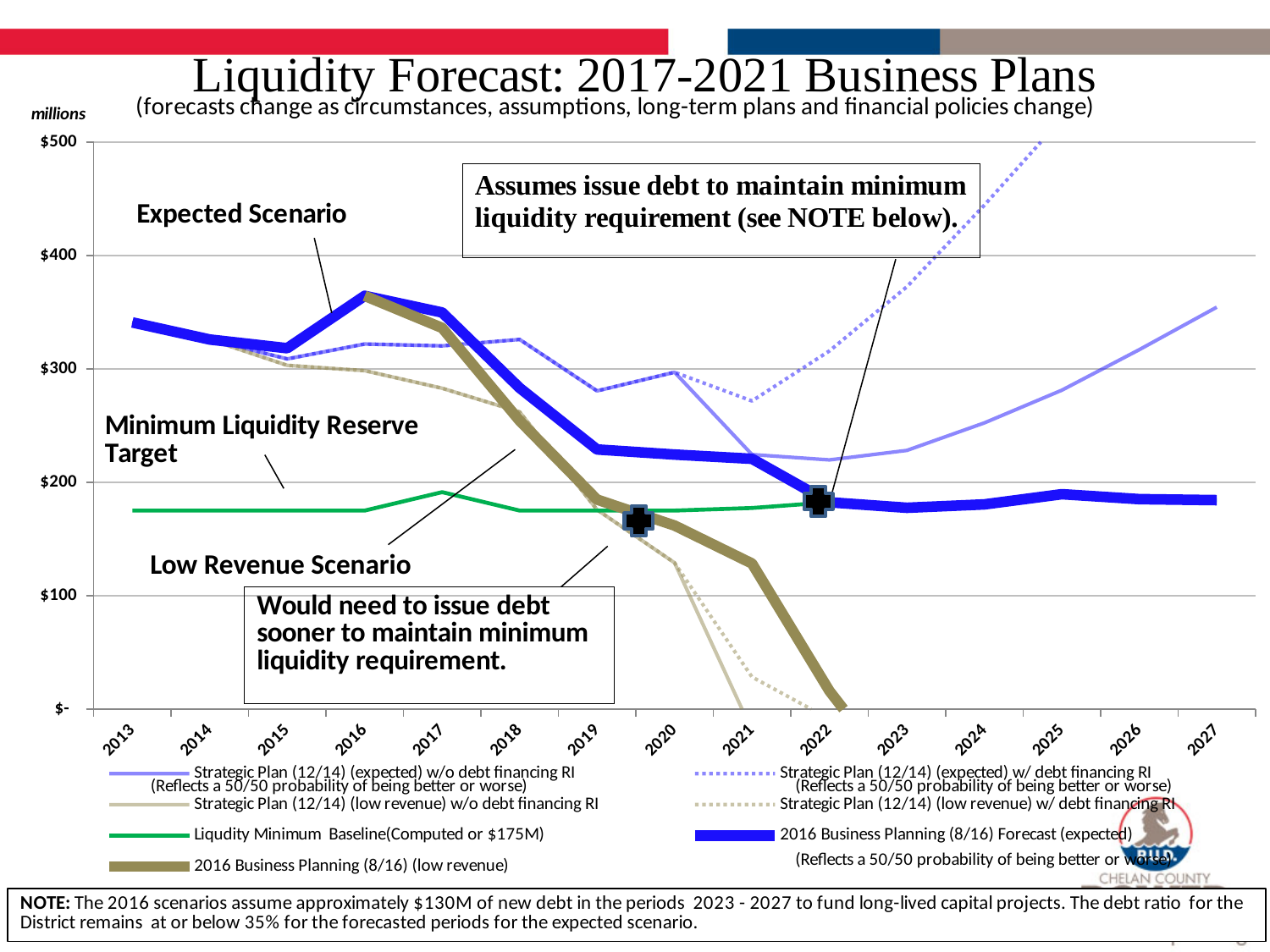
In which year does the 2016 Business Planning (8/16) Forecast (expected) reach its highest value? 2016 Is the value of the 2016 Business Planning (8/16) (low revenue) series in 2021 greater or less than $200? less In 2020, which is larger: the 2016 Business Planning (8/16) Forecast (expected) or the 2016 Business Planning (8/16) (low revenue)? 2016 Business Planning (8/16) Forecast (expected) How many years are shown along the x axis? 15 Is the value of the 2016 Business Planning (8/16) Forecast (expected) in 2016 greater or less than $300? greater What kind of chart is shown on the slide? line chart Is the value of the 2016 Business Planning (8/16) Forecast (expected) in 2022 greater or less than $200? less Does the 2016 Business Planning (8/16) (low revenue) series rise or fall from 2016 to 2022? fall What is the title of the chart? Liquidity Forecast: 2017-2021 Business Plans In what unit are the values on the y axis expressed? millions How many series does the legend list? 7